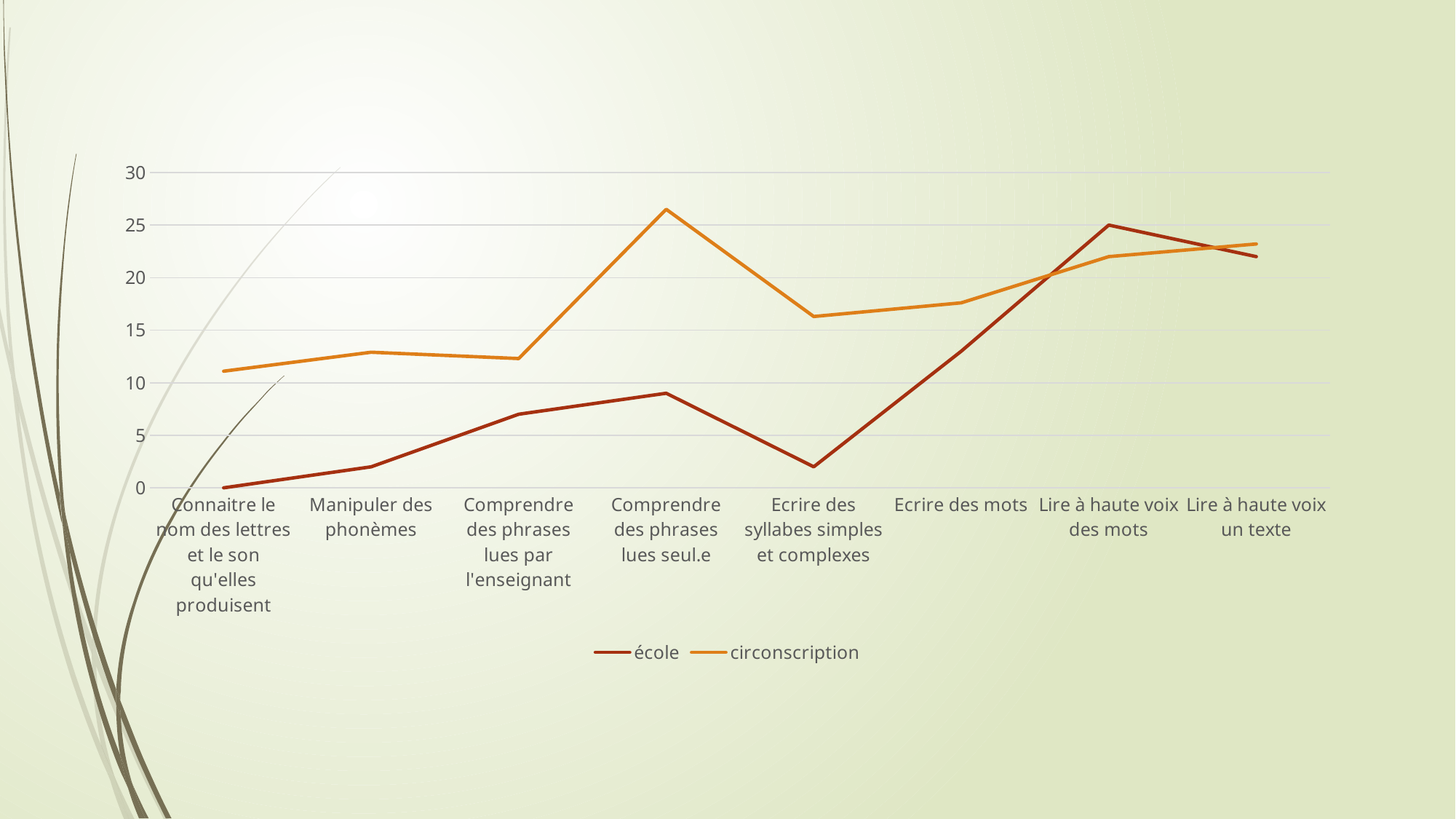
For 'Comprendre des phrases lues seul.e', which series has the higher value, école or circonscription? circonscription What is the value of the école series for 'Connaitre le nom des lettres et le son qu'elles produisent'? 0 For 'Lire à haute voix des mots', which series has the higher value, école or circonscription? école For which category is the école series lowest? Connaitre le nom des lettres et le son qu'elles produisent For which category is the circonscription series lowest? Connaitre le nom des lettres et le son qu'elles produisent How many series does the legend list? 2 Is the école value for 'Ecrire des mots' greater or less than 10? greater What kind of chart is shown on the slide? line chart Is the circonscription value for 'Ecrire des syllabes simples et complexes' greater or less than 15? greater For which category does the école series reach its highest value? Lire à haute voix des mots How many categories are shown along the x axis? 8 For which category does the circonscription series reach its highest value? Comprendre des phrases lues seul.e